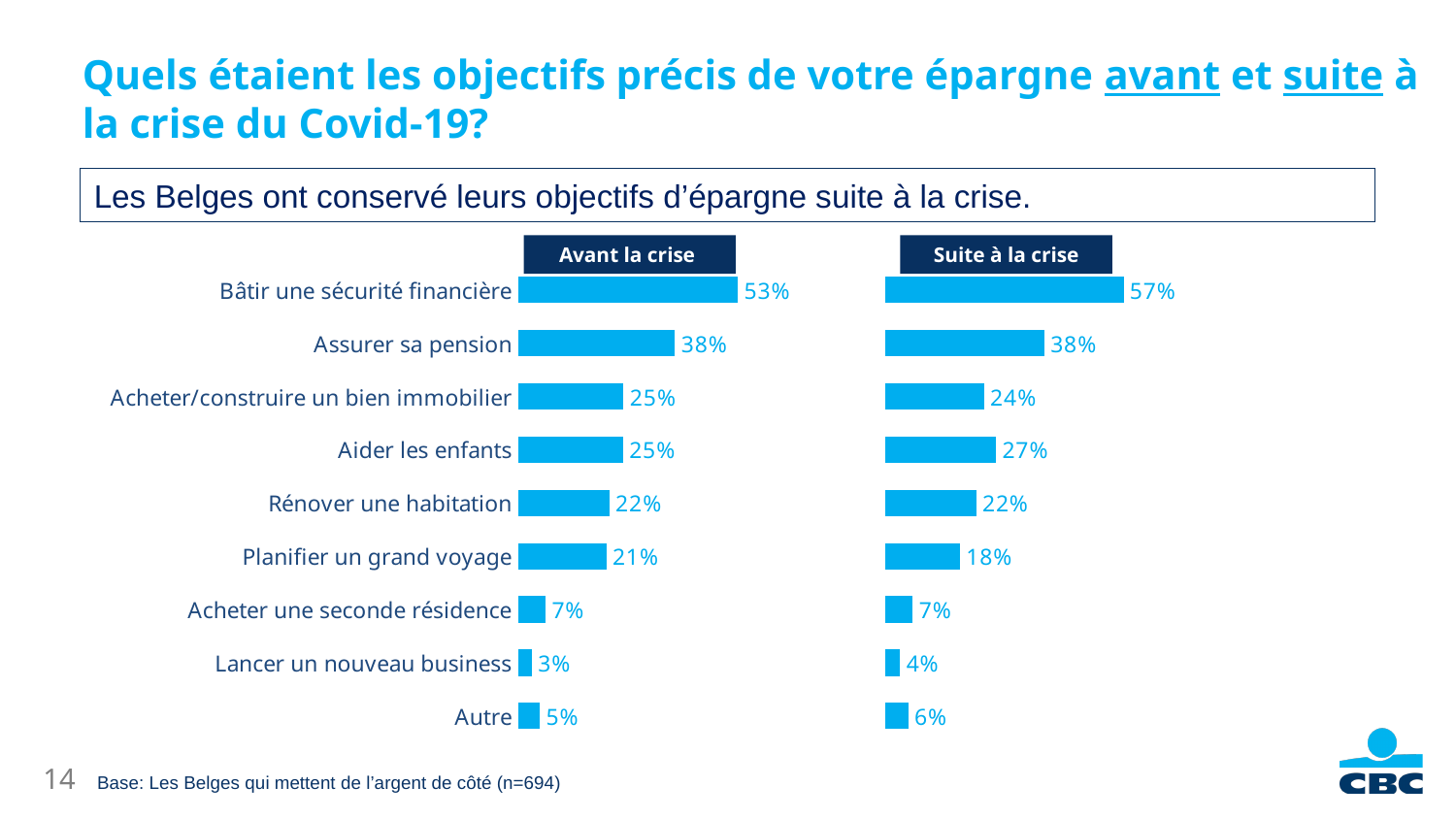
How many categories are shown in the 'Avant la crise' chart? 9 Which is larger: the 'Avant la crise' value for 'Planifier un grand voyage' or the 'Suite à la crise' value for 'Planifier un grand voyage'? Avant la crise In the 'Suite à la crise' chart, what is the value for 'Planifier un grand voyage'? 18% In the 'Avant la crise' chart, which category has the highest value? Bâtir une sécurité financière What is the difference between the 'Suite à la crise' and 'Avant la crise' values for 'Bâtir une sécurité financière'? 4% In the 'Avant la crise' chart, what is the value for 'Bâtir une sécurité financière'? 53% In the 'Avant la crise' chart, which category has the lowest value? Lancer un nouveau business What kind of chart is the 'Suite à la crise' chart? Bar chart In the 'Suite à la crise' chart, which category has the lowest value? Lancer un nouveau business What is the title of the chart on the right? Suite à la crise In the 'Avant la crise' chart, what is the value for 'Assurer sa pension'? 38% In the 'Suite à la crise' chart, what is the value for 'Aider les enfants'? 27%